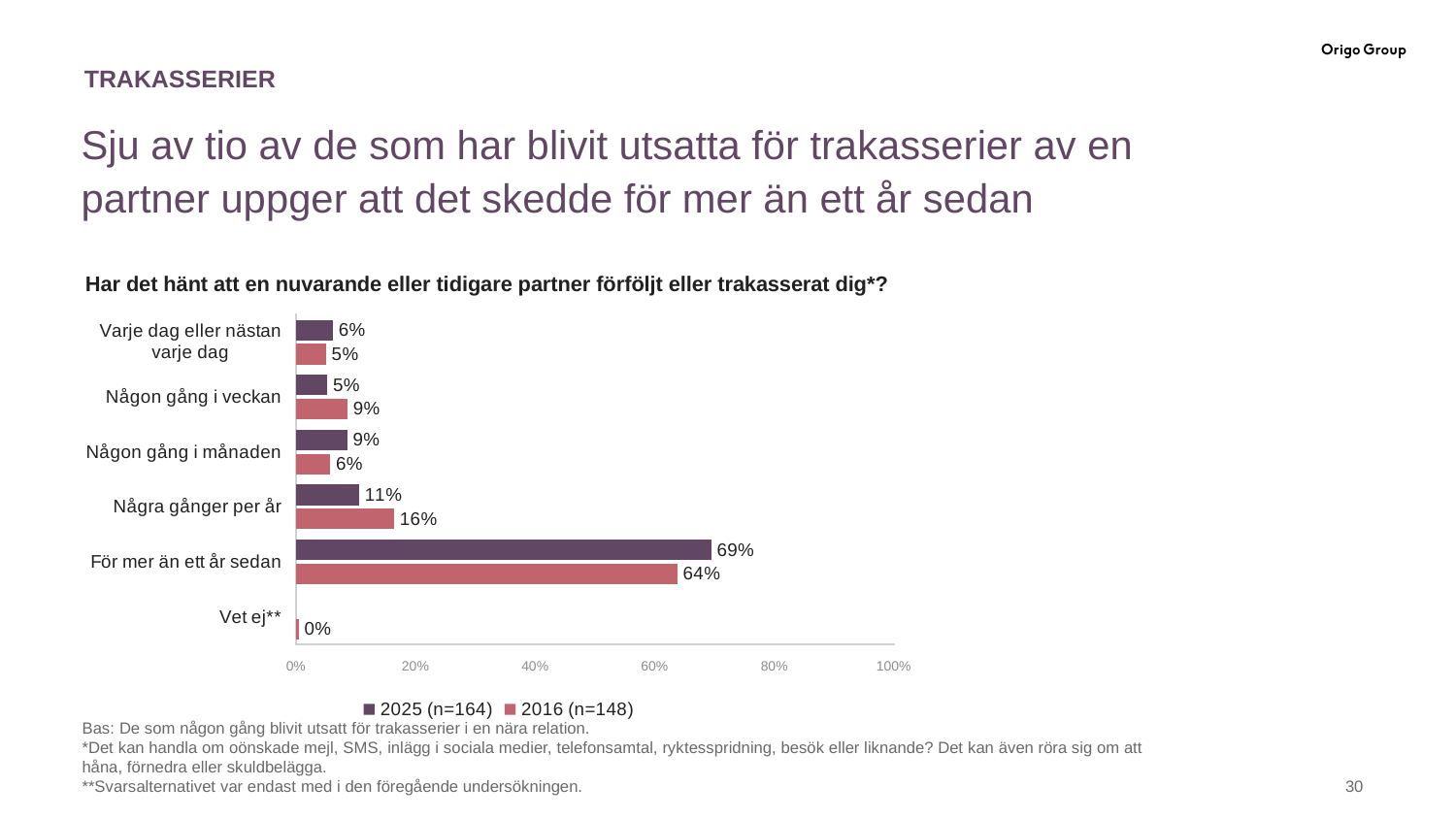
Which category has the lowest value in the 2016 (n=148) series? Vet ej** How many categories are shown on the chart? 6 What are the two series listed in the legend? 2025 (n=164) and 2016 (n=148) What is the difference between the 2025 (n=164) and 2016 (n=148) values for "För mer än ett år sedan"? 5% Which category has the highest value in the 2016 (n=148) series? För mer än ett år sedan Is the 2025 (n=164) value for "För mer än ett år sedan" greater or less than 60%? greater What is the value for "För mer än ett år sedan" in the 2025 (n=164) series? 69% What is the value for "Någon gång i veckan" in the 2025 (n=164) series? 5% What kind of chart is shown on the slide? Bar chart How many series does the legend list? 2 For "Någon gång i veckan", which series has the larger value, 2025 (n=164) or 2016 (n=148)? 2016 (n=148) What is the value for "Några gånger per år" in the 2016 (n=148) series? 16%